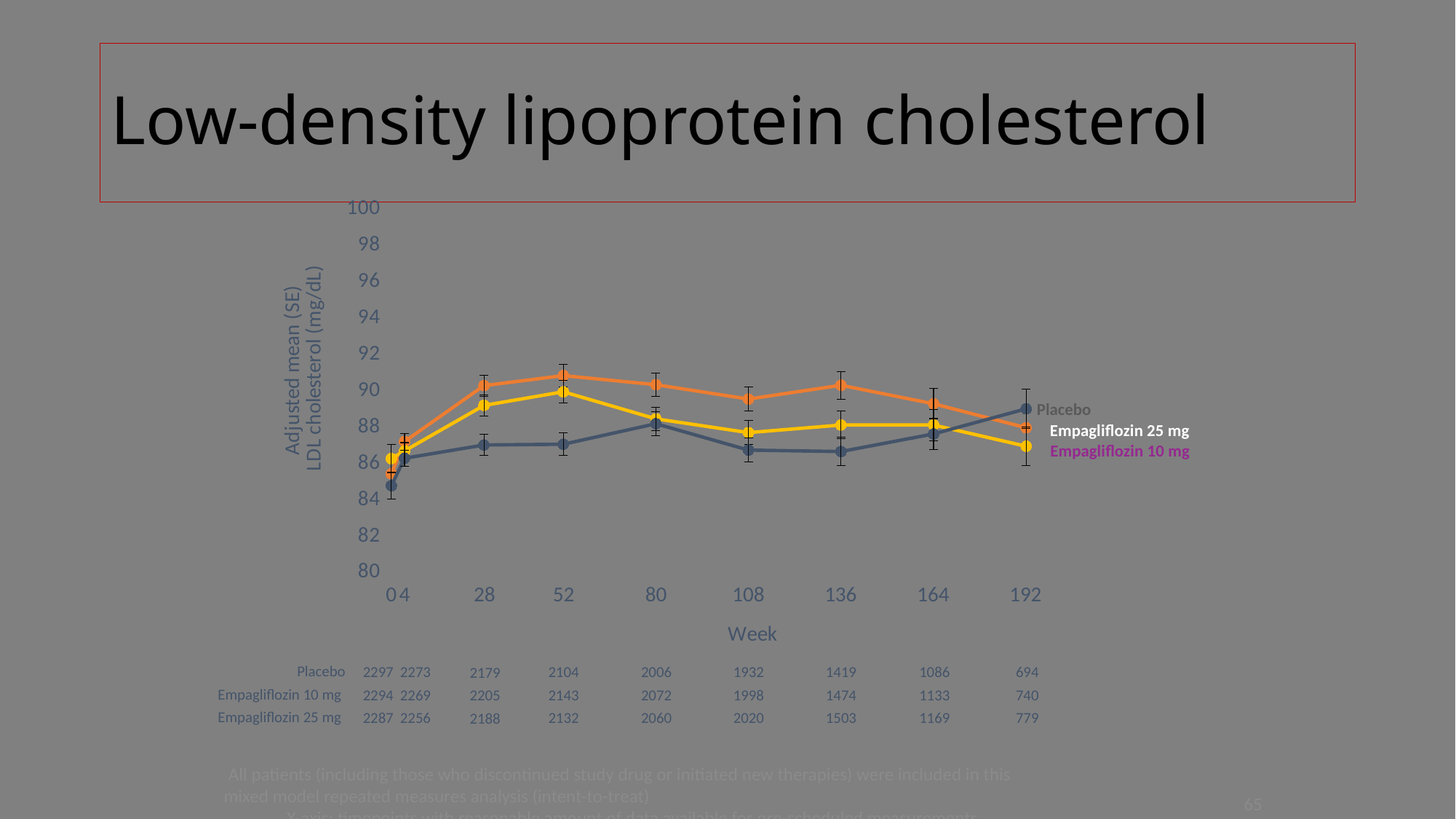
How many time points are shown on the x axis of the chart? 9 Is the Empagliflozin 10 mg value at week 192 greater or less than 88? less Is the Empagliflozin 25 mg value at week 52 greater or less than 90? greater At week 192, which is larger: the Placebo value or the Empagliflozin 10 mg value? Placebo Does the Placebo line rise or fall from week 136 to week 192? rise What kind of chart is shown on the slide? line chart How many series are plotted in the chart? 3 Which series has the highest value at week 80? Empagliflozin 25 mg Is the Placebo value at week 136 greater or less than 88? less At week 52, which is larger: the Empagliflozin 25 mg value or the Placebo value? Empagliflozin 25 mg What is the label of the y axis of the chart? Adjusted mean (SE) LDL cholesterol (mg/dL)